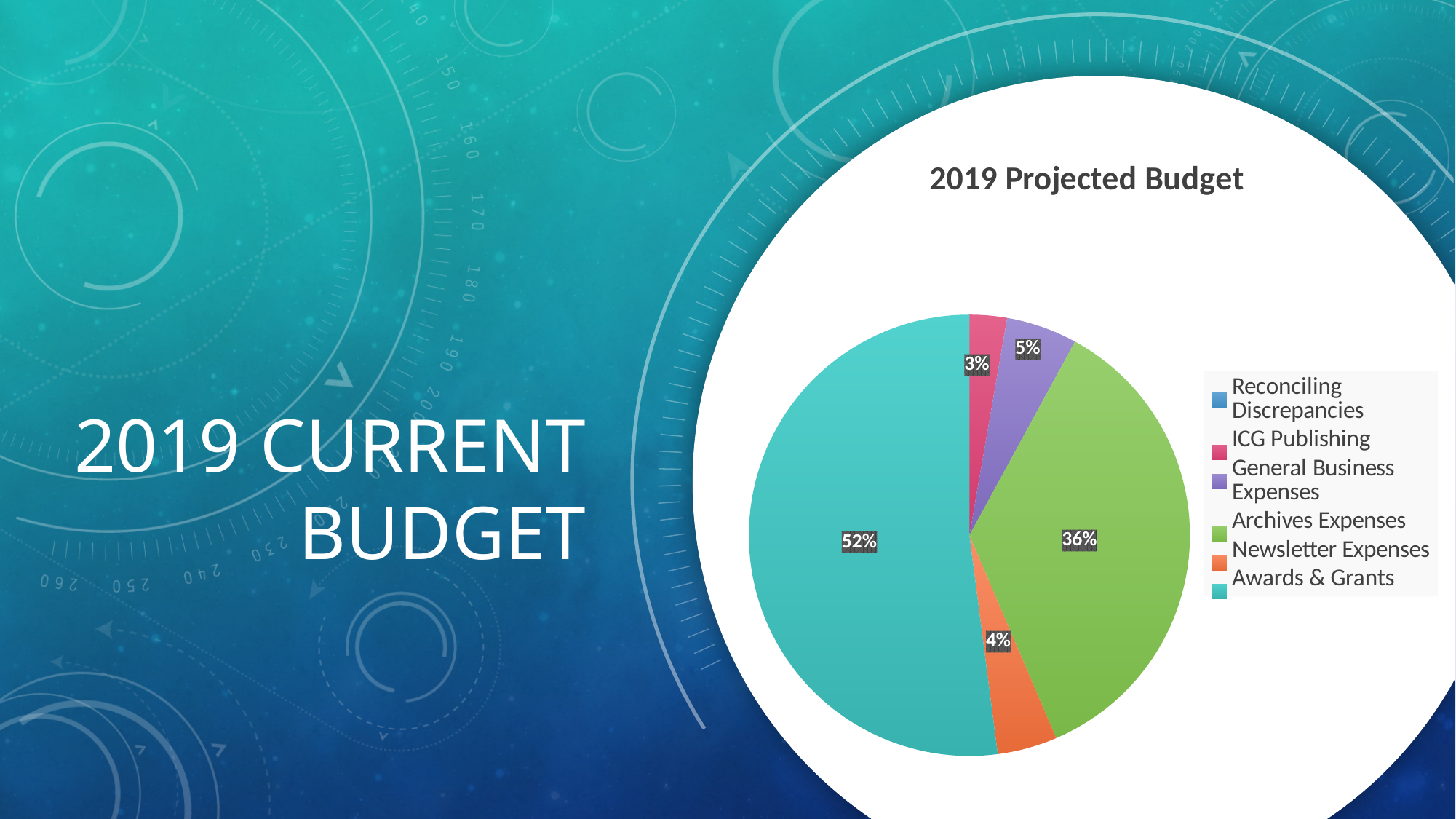
What percentage is shown for General Business Expenses? 5% What is the title of the chart? 2019 Projected Budget Which category has the largest slice of the pie? Awards & Grants Which is larger, Archives Expenses or Awards & Grants? Awards & Grants What percentage is shown for ICG Publishing? 3% What kind of chart is shown on the slide? pie chart By how many percentage points does Awards & Grants exceed Archives Expenses? 16 percentage points What percentage of the pie is Archives Expenses? 36% How many categories are listed in the chart's legend? 6 Which is larger, General Business Expenses or Newsletter Expenses? General Business Expenses What percentage is shown for Newsletter Expenses? 4% What share of the 2019 Projected Budget goes to Awards & Grants? 52%